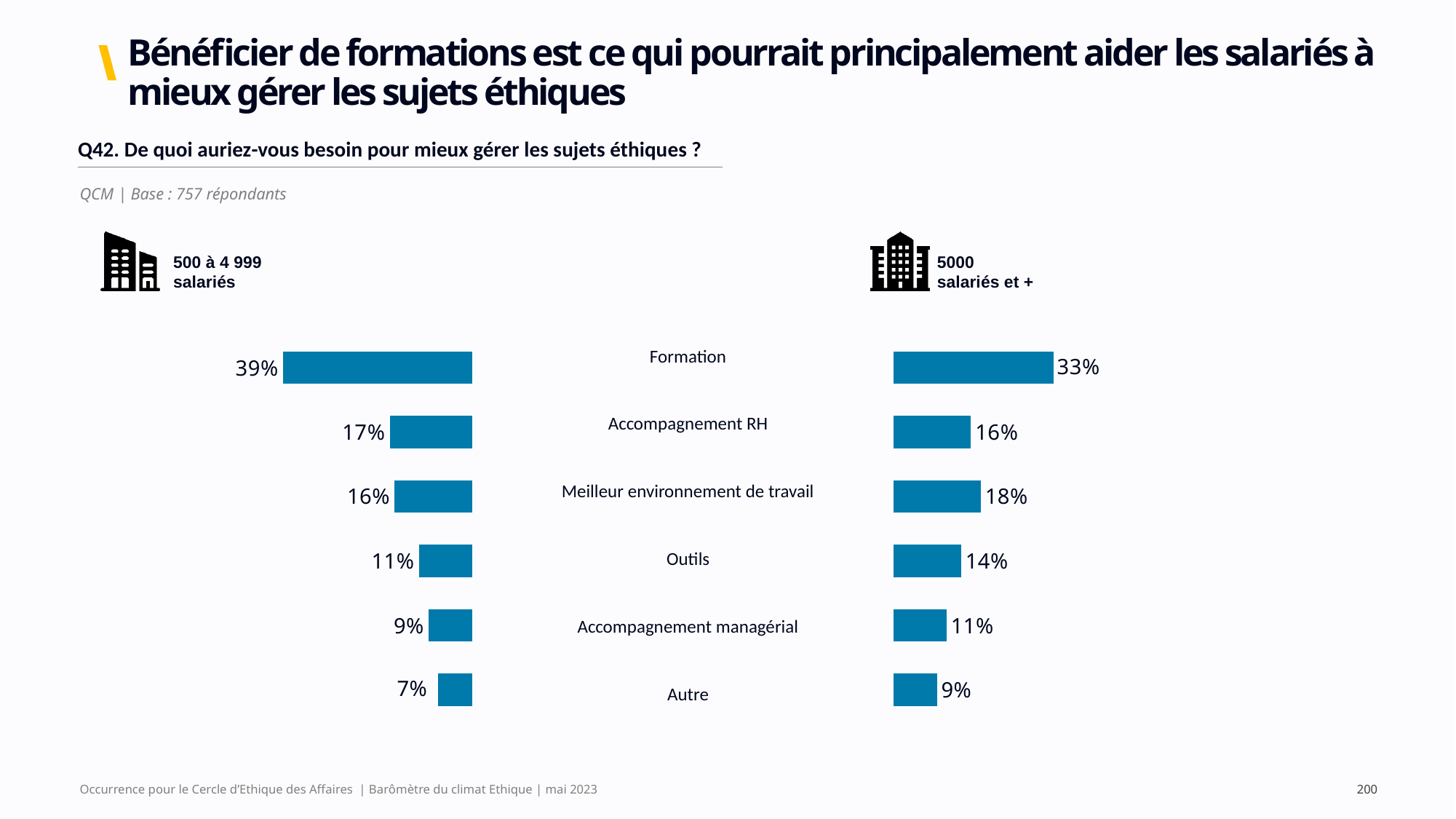
In the right chart (5000 salariés et +), what is the value for Meilleur environnement de travail? 18% What type of chart is used on this slide? Bar chart In the left chart (500 à 4 999 salariés), what is the value for Formation? 39% What is the difference between the Formation values in the left chart (500 à 4 999 salariés) and the right chart (5000 salariés et +)? 6 percentage points In the right chart (5000 salariés et +), what is the value for Outils? 14% Which is larger: Outils in the left chart (500 à 4 999 salariés) or Outils in the right chart (5000 salariés et +)? Right chart (5000 salariés et +) In the left chart (500 à 4 999 salariés), which category has the highest value? Formation What is the base (number of respondents) stated on the slide? 757 répondants In the right chart (5000 salariés et +), which category has the lowest value? Autre How many categories are shown in the left chart (500 à 4 999 salariés)? 6 In the right chart (5000 salariés et +), what is the difference between Formation and Accompagnement RH? 17 percentage points In the left chart (500 à 4 999 salariés), what is the value for Accompagnement managérial? 9%